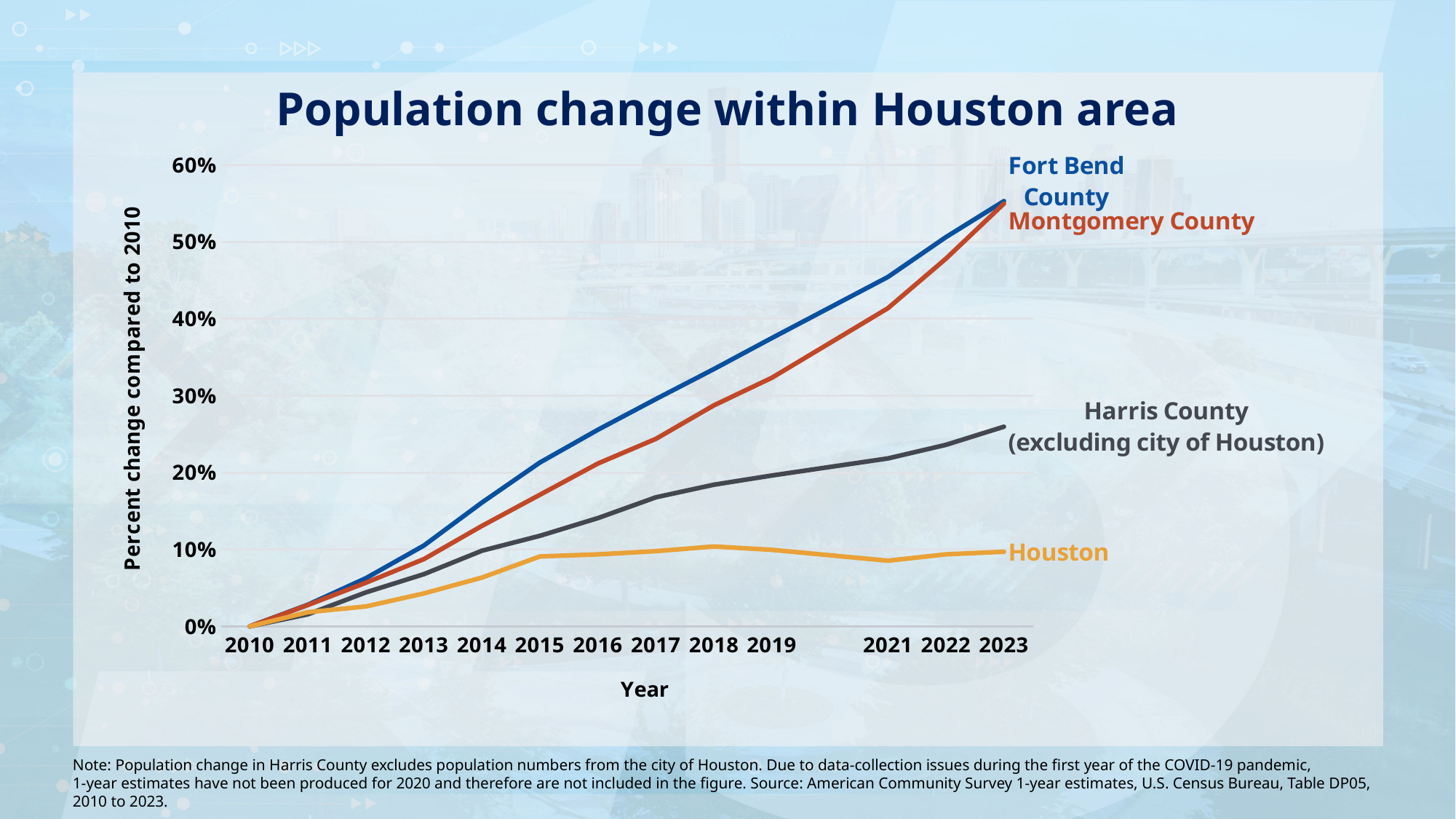
What is the value for Fort Bend County in 2010? 0% Which series has the lowest value in 2023? Houston Does the Fort Bend County line rise or fall from 2010 to 2023? rise Is the value for Harris County (excluding city of Houston) in 2023 greater or less than 20%? greater How many years are shown on the x axis of the chart? 13 How many series are plotted on the chart? 4 In 2023, which is larger: Harris County (excluding city of Houston) or Houston? Harris County (excluding city of Houston) What kind of chart is shown on the slide? line chart Is the value for Houston in 2023 greater or less than 20%? less Is the value for Montgomery County in 2023 greater or less than 50%? greater Which year between 2010 and 2023 is missing from the x axis? 2020 Which series has the highest value in 2016? Fort Bend County